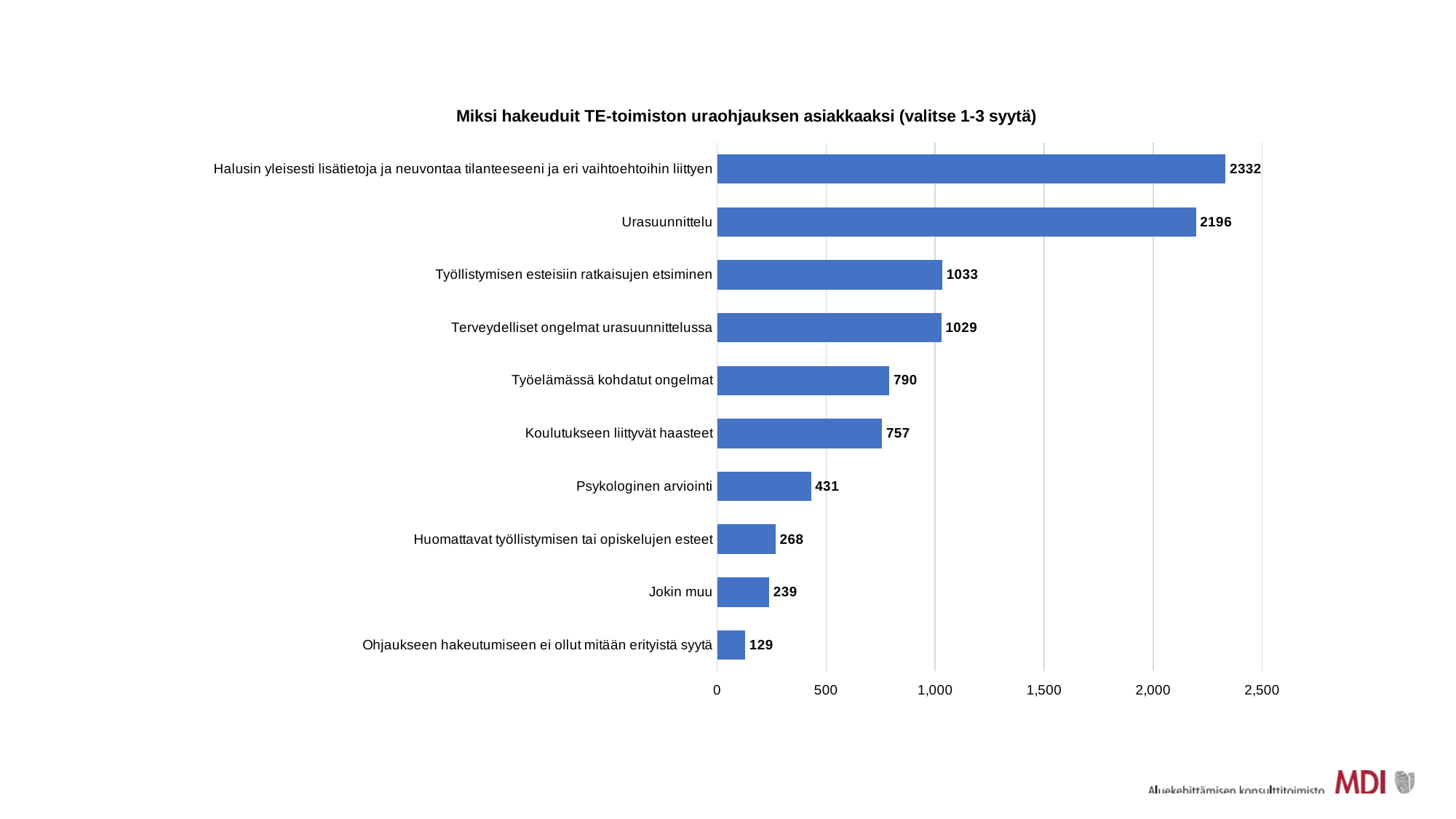
Which category has the highest value? Halusin yleisesti lisätietoja ja neuvontaa tilanteeseeni ja eri vaihtoehtoihin liittyen Which category has the lowest value? Ohjaukseen hakeutumiseen ei ollut mitään erityistä syytä What kind of chart is shown on the slide? bar chart What is the value for Urasuunnittelu? 2196 How many categories are shown in the chart? 10 What is the value for Psykologinen arviointi? 431 What is the value for Jokin muu? 239 Which is larger: the value for Huomattavat työllistymisen tai opiskelujen esteet or the value for Jokin muu? Huomattavat työllistymisen tai opiskelujen esteet What is the title of the chart? Miksi hakeuduit TE-toimiston uraohjauksen asiakkaaksi (valitse 1-3 syytä) Is the value for Terveydelliset ongelmat urasuunnittelussa greater or less than 1,000? greater What is the difference between the values for Urasuunnittelu and Työllistymisen esteisiin ratkaisujen etsiminen? 1163 What is the difference between the values for Työelämässä kohdatut ongelmat and Koulutukseen liittyvät haasteet? 33